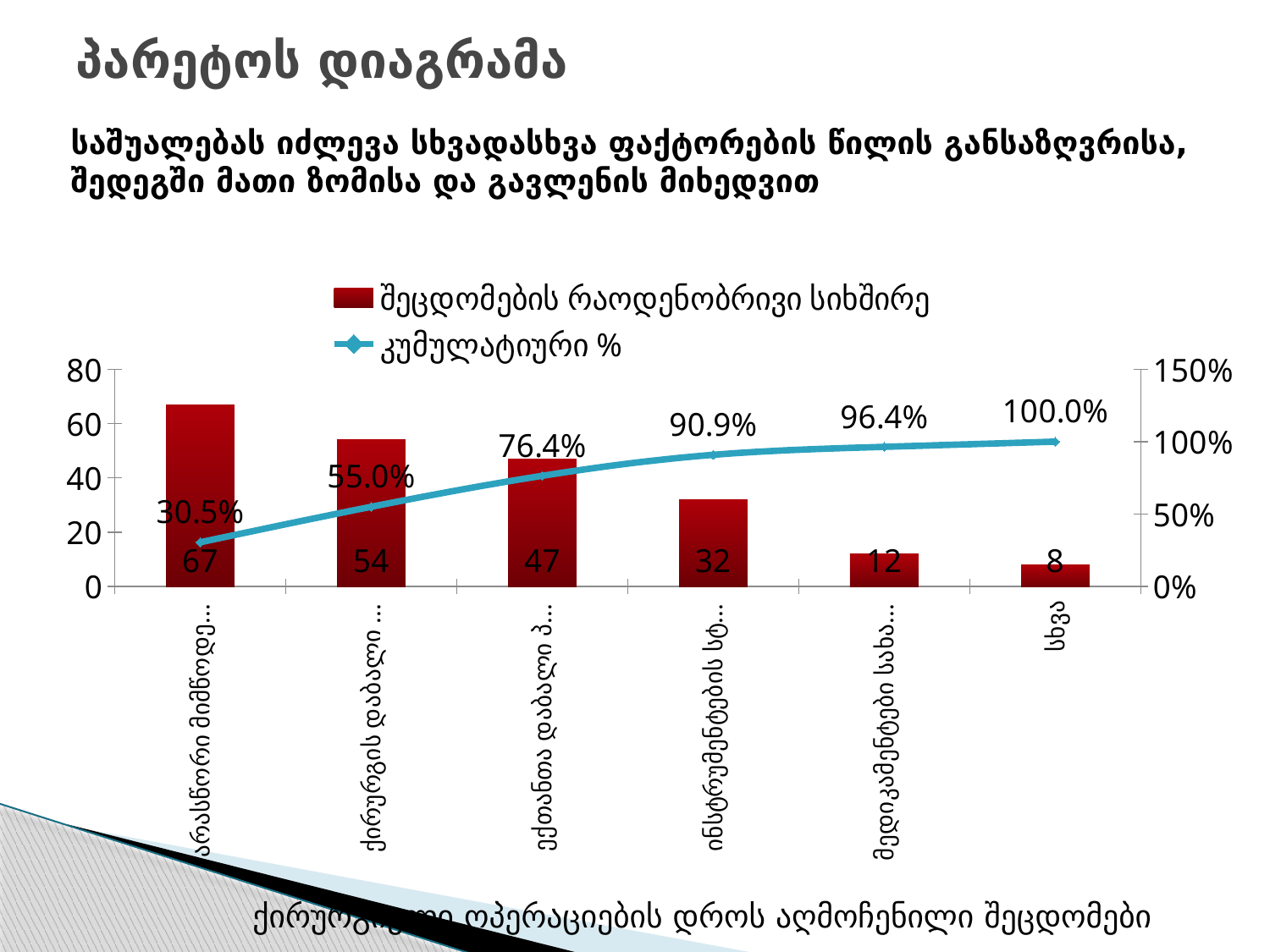
Which is larger: the fourth bar from the left or the fifth bar from the left? The fourth bar (32) What is the difference between the first bar (67) and the second bar (54)? 13 What is the value of the tallest bar in the chart? 67 How many series does the legend list? 2 Which legend entry corresponds to the red bars? შეცდომების რაოდენობრივი სიხშირე Which category has the lowest bar value? სხვა What is the value of the bar for the category "სხვა"? 8 What is the cumulative percentage (კუმულატიური %) shown at the category "სხვა"? 100.0% What kind of chart is shown on the slide? A bar chart combined with a line chart Do the bar values rise or fall from left to right along the x axis? Fall What is the cumulative percentage label at the fourth category from the left? 90.9% How many categories are plotted on the x axis? 6